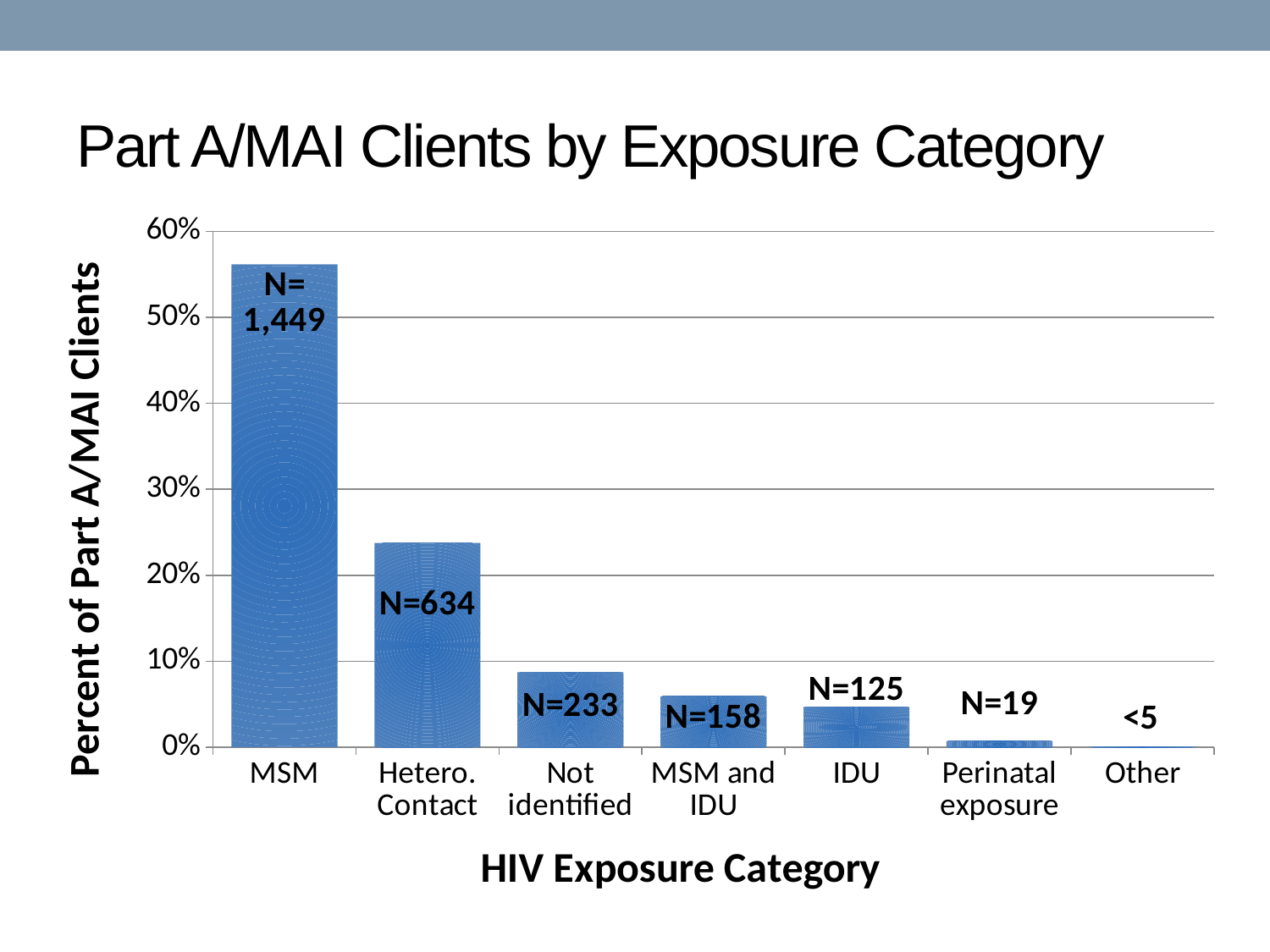
What N value is labelled on the IDU bar? N=125 Is the percent of clients for MSM greater or less than 50%? greater What is the title of the chart? Part A/MAI Clients by Exposure Category What label is shown above the Other bar? <5 Which has a larger percent of Part A/MAI clients, Not identified or IDU? Not identified What kind of chart is shown on the slide? bar chart What N value is labelled on the Hetero. Contact bar? N=634 What N value is labelled on the MSM bar? N= 1,449 Is the percent of clients for Hetero. Contact greater or less than 30%? less Which exposure category has the lowest percent of Part A/MAI clients? Other How many HIV exposure categories are shown on the x axis? 7 Which exposure category has the highest percent of Part A/MAI clients? MSM